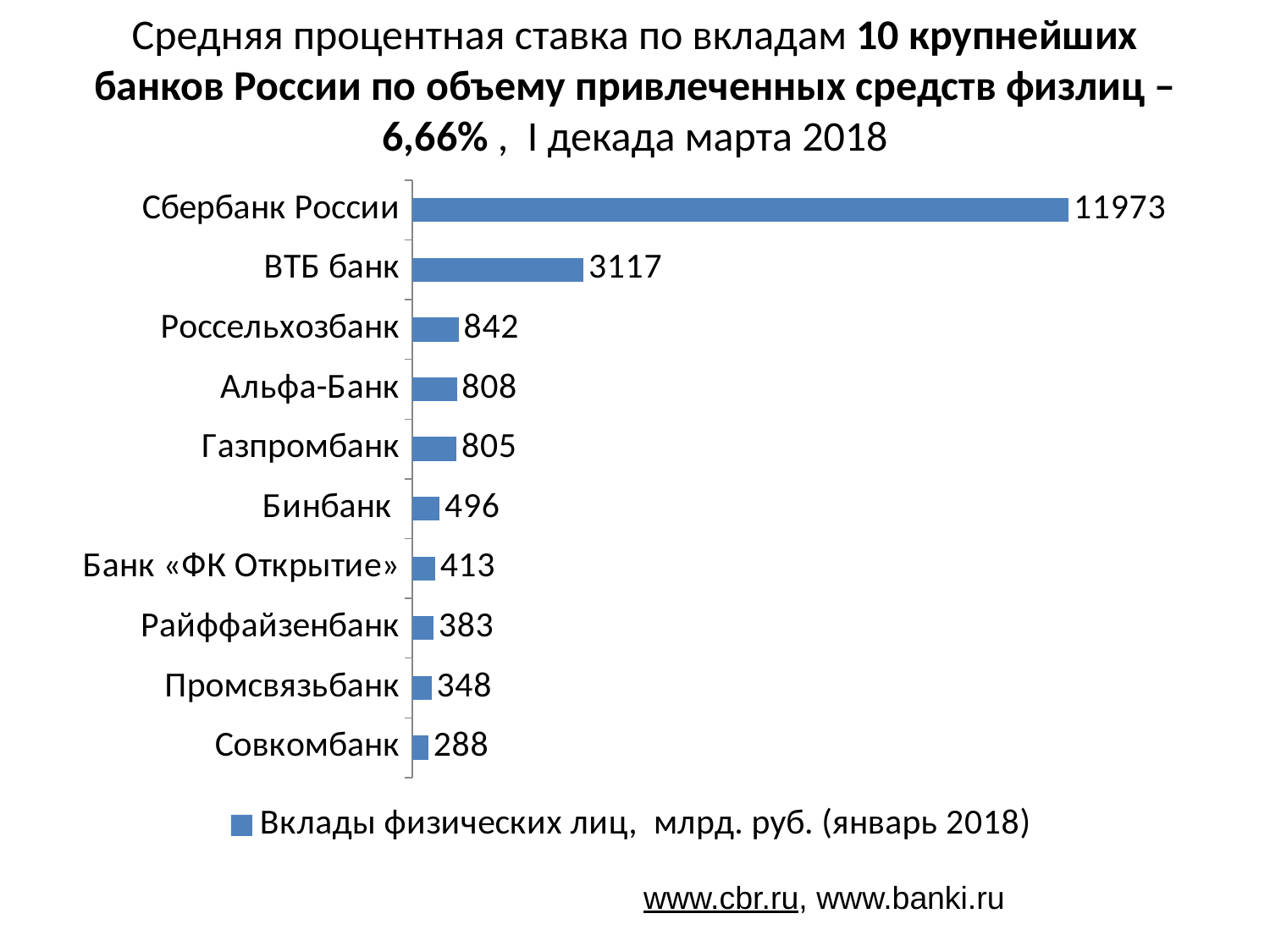
What is the value for Газпромбанк? 805 What is the value for Совкомбанк? 288 How many banks are shown in the chart? 10 What is the value for ВТБ банк? 3117 What is the difference between the values for Сбербанк России and ВТБ банк? 8856 What is the value for Сбербанк России? 11973 What is the legend entry of the chart? Вклады физических лиц, млрд. руб. (январь 2018) What kind of chart is shown on the slide? Bar chart Which bank has the highest value? Сбербанк России Which bank has the lowest value? Совкомбанк Which is larger, the value for Бинбанк or the value for Банк «ФК Открытие»? Бинбанк What is the difference between the values for Россельхозбанк and Альфа-Банк? 34